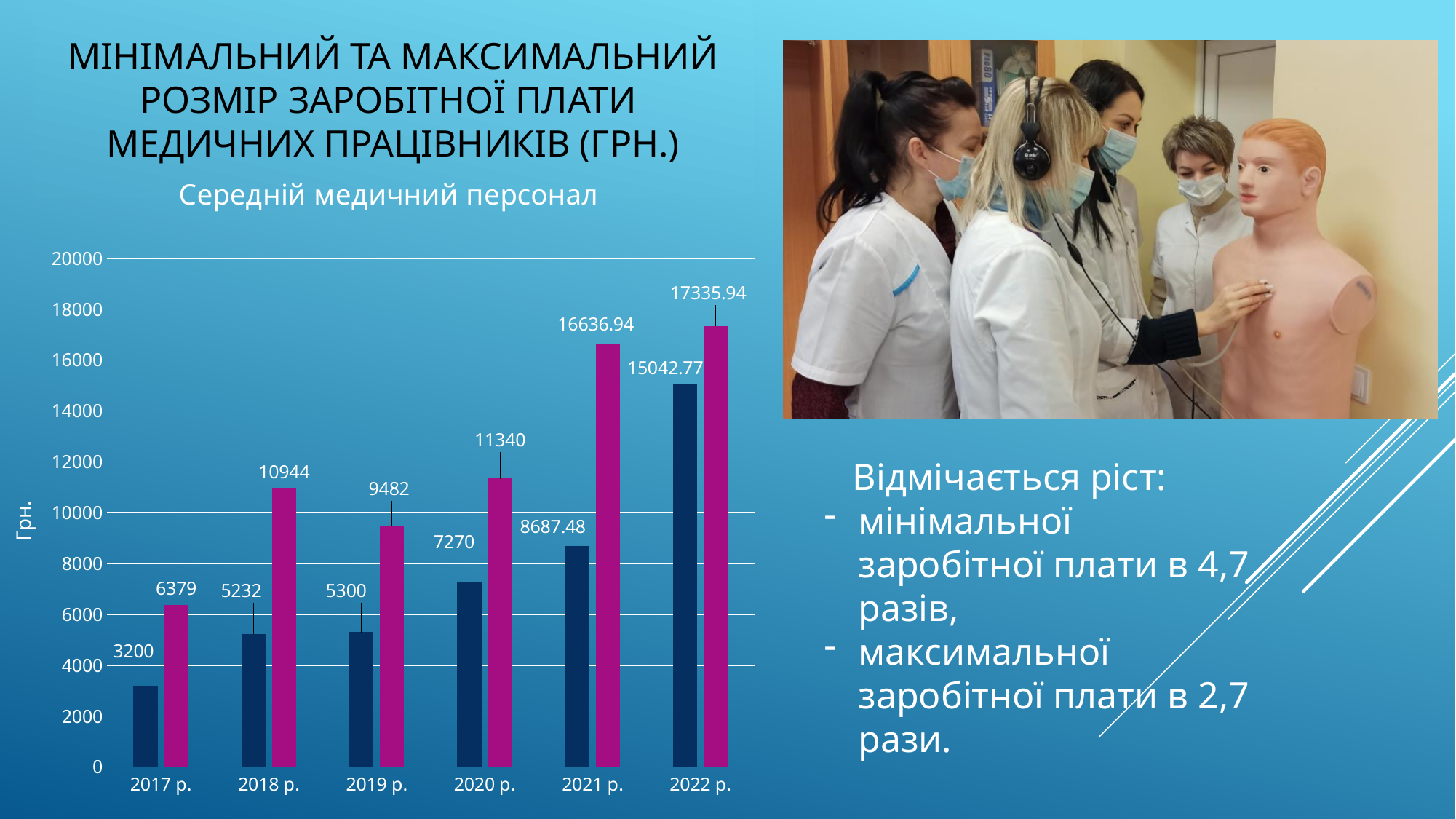
What is the value of the magenta bar for 2021 р.? 16636.94 In which year is the magenta bar highest? 2022 р. What is the value of the dark blue bar for 2022 р.? 15042.77 What is the difference between the magenta and dark blue bars for 2020 р.? 4070 What is the value of the magenta bar for 2019 р.? 9482 Which is larger: the magenta bar for 2018 р. or the magenta bar for 2019 р.? 2018 р. What is the title shown above the chart? Середній медичний персонал In which year is the dark blue bar lowest? 2017 р. What is the value of the dark blue bar for 2017 р.? 3200 How many years are shown on the x axis of the chart? 6 What kind of chart is shown on the slide? bar chart Is the value of the dark blue bar for 2021 р. greater or less than 8000? greater